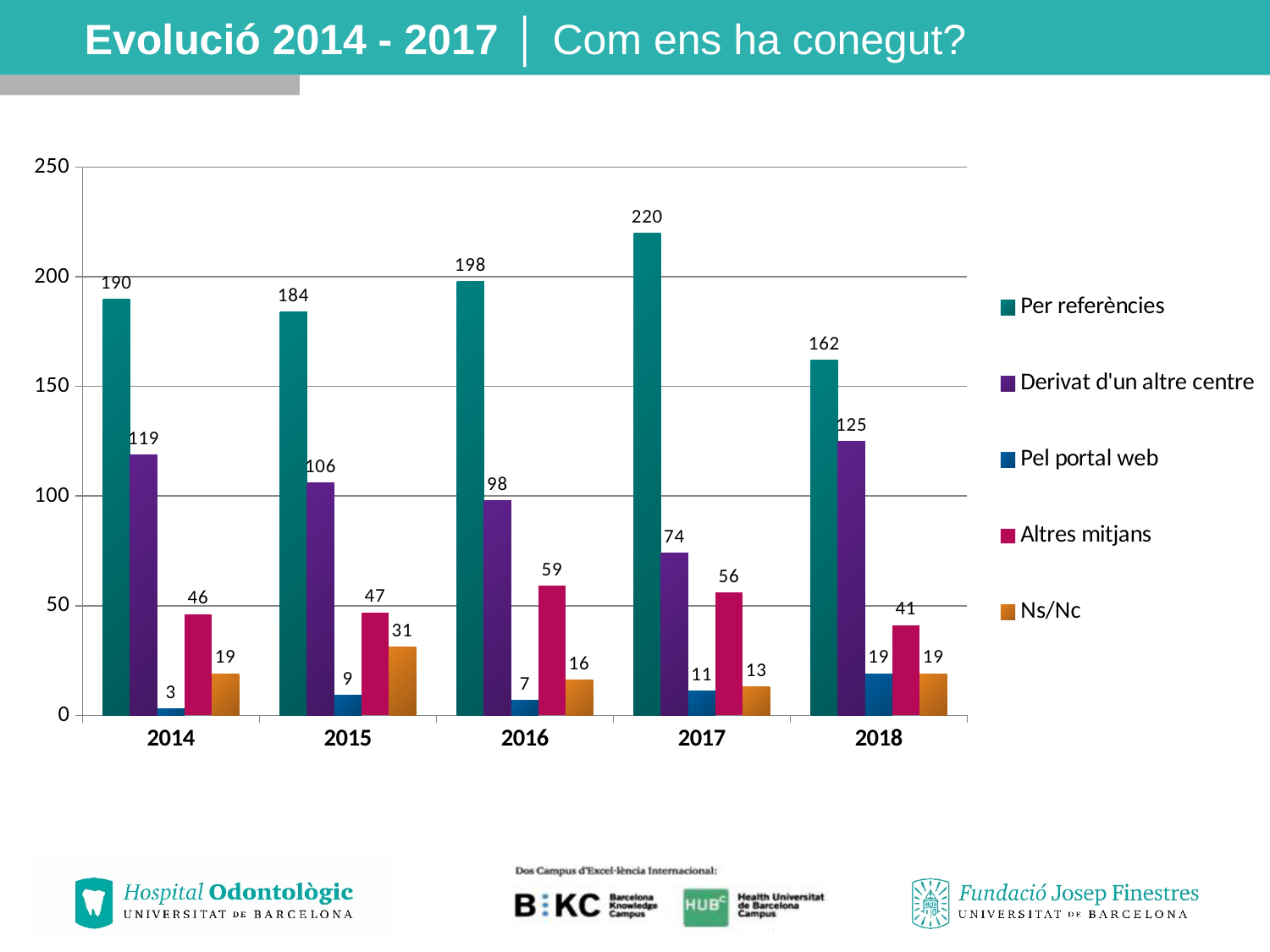
What is the value for "Per referències" in 2016? 198 What is the difference between the "Per referències" values for 2017 and 2018? 58 Which series is shown in orange in the legend? Ns/Nc How many years are shown on the x axis? 5 What is the value for "Altres mitjans" in 2015? 47 What kind of chart is shown on the slide? Bar chart What is the value for "Pel portal web" in 2014? 3 How many series does the legend list? 5 What is the value for "Derivat d'un altre centre" in 2018? 125 In which year is the value for "Ns/Nc" lowest? 2017 In which year is the value for "Per referències" highest? 2017 Which is larger: "Altres mitjans" in 2016 or "Altres mitjans" in 2017? 2016